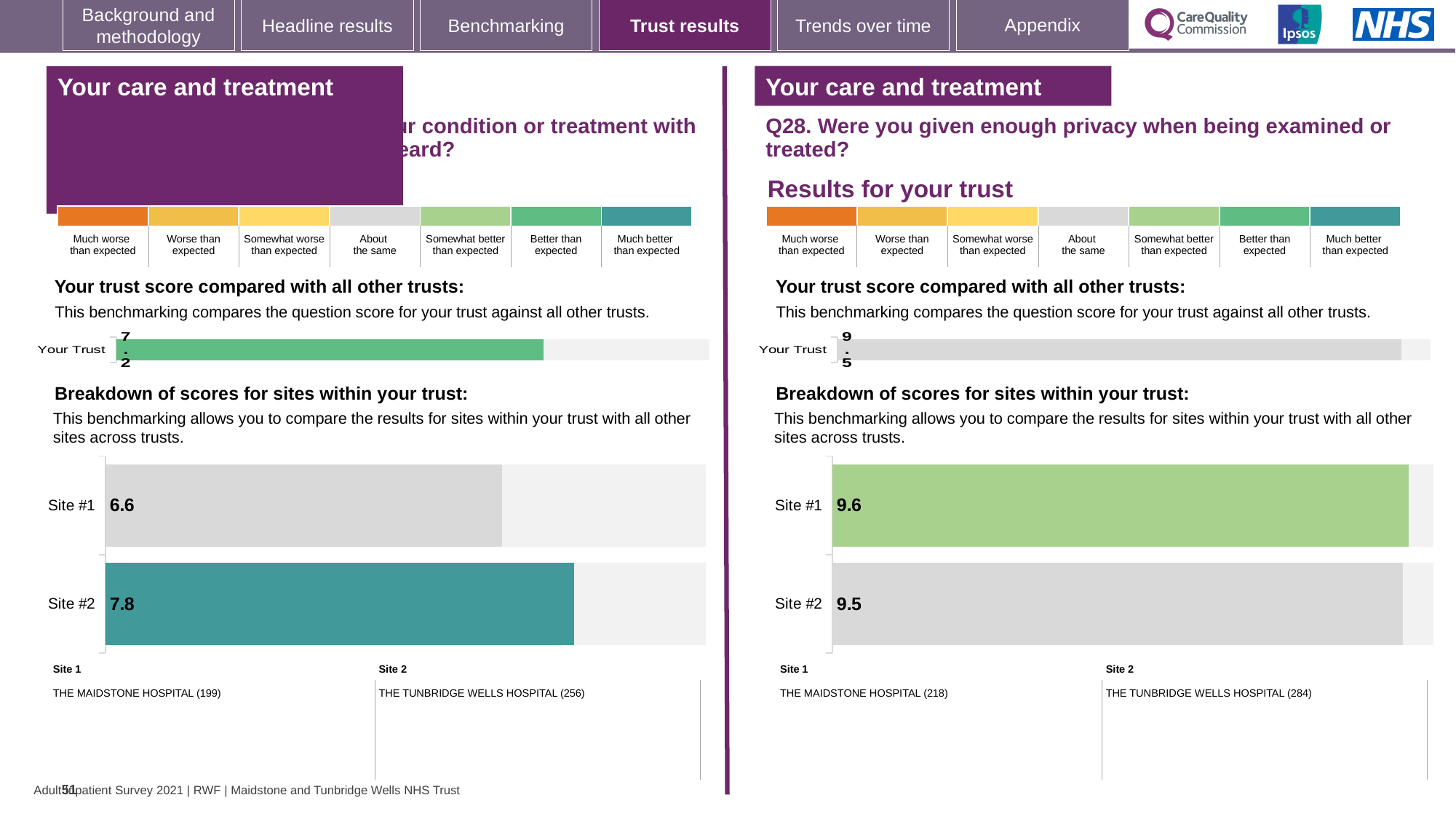
In the left-hand site breakdown chart, what is the score for Site #2? 7.8 What is the 'Your Trust' score shown in the Q28 trust benchmarking bar on the right? 9.5 How many sites are shown in the Q28 site breakdown chart on the right? 2 In the left-hand site breakdown chart, what is the difference between the Site #2 and Site #1 scores? 1.2 In the Q28 site breakdown chart on the right, what is the score for Site #2? 9.5 In the left-hand site breakdown chart, what is the score for Site #1? 6.6 What type of chart is used for the site breakdown on the left-hand side of the slide? Bar chart What is the 'Your Trust' score shown in the left-hand trust benchmarking bar? 7.2 In the Q28 site breakdown chart on the right, what is the difference between the Site #1 and Site #2 scores? 0.1 In the Q28 site breakdown chart on the right, what is the score for Site #1? 9.6 In the left-hand site breakdown chart, which site has the higher score? Site #2 In the left-hand site breakdown chart, is the Site #1 score greater or less than the Site #2 score? less